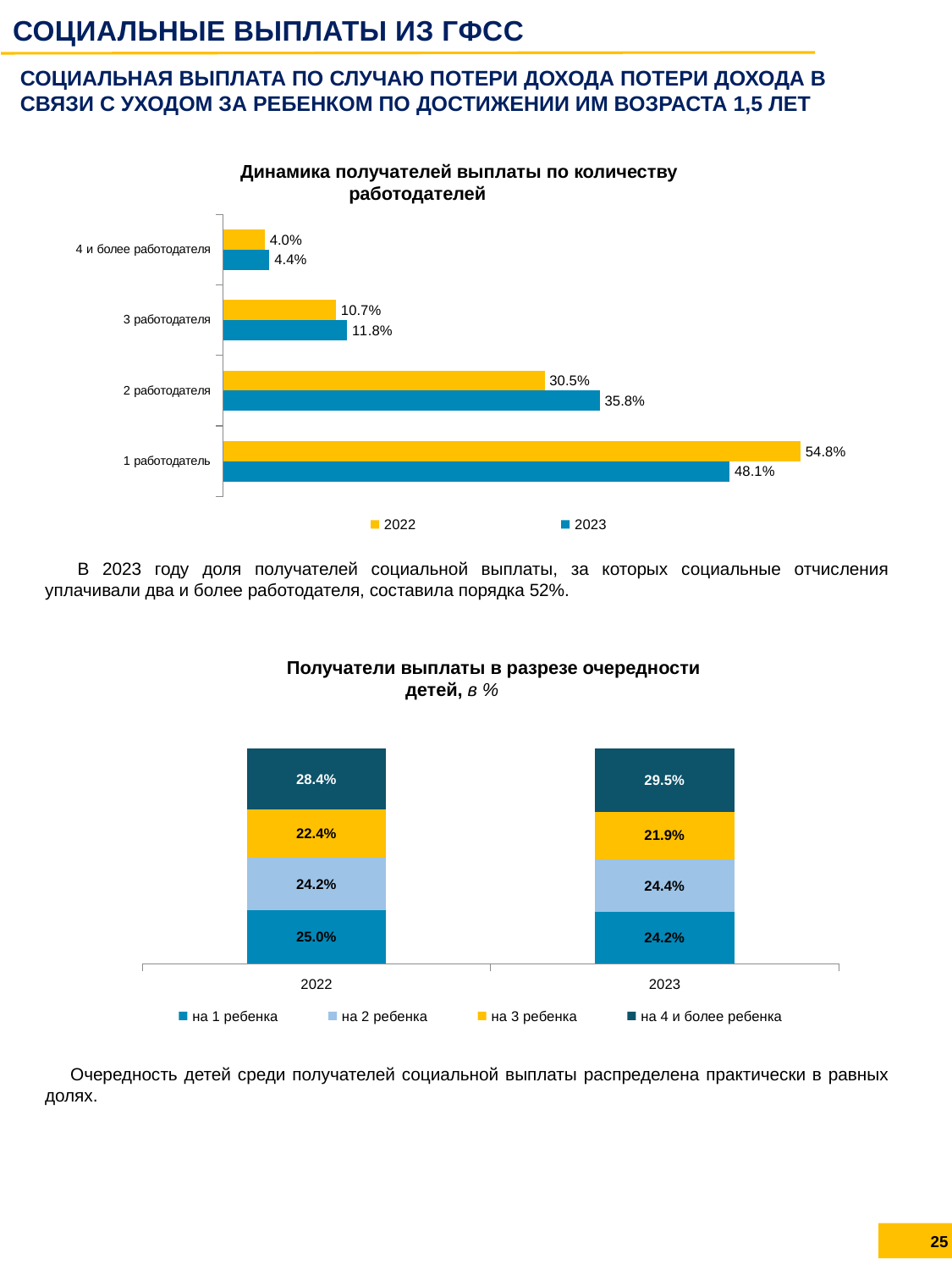
In the chart 'Получатели выплаты в разрезе очередности детей', what is the 2023 value for 'на 4 и более ребенка'? 29.5% In the chart 'Динамика получателей выплаты по количеству работодателей', how many series does the legend list? 2 In the chart 'Получатели выплаты в разрезе очередности детей', which series has the highest value in 2022? на 4 и более ребенка In the chart 'Получатели выплаты в разрезе очередности детей', what is the difference between the 2022 and 2023 values for 'на 3 ребенка'? 0.5% In the chart 'Динамика получателей выплаты по количеству работодателей', what is the 2022 value for '1 работодатель'? 54.8% In the chart 'Динамика получателей выплаты по количеству работодателей', which category has the lowest 2023 value? 4 и более работодателя In the chart 'Динамика получателей выплаты по количеству работодателей', which is larger for '3 работодателя': the 2022 value or the 2023 value? 2023 What kind of chart is 'Динамика получателей выплаты по количеству работодателей'? Bar chart In the chart 'Динамика получателей выплаты по количеству работодателей', what is the 2023 value for '2 работодателя'? 35.8% In the chart 'Получатели выплаты в разрезе очередности детей', what is the 2022 value for 'на 1 ребенка'? 25.0% In the chart 'Получатели выплаты в разрезе очередности детей', how many series does the legend list? 4 In the chart 'Динамика получателей выплаты по количеству работодателей', what is the difference between the 2022 and 2023 values for '1 работодатель'? 6.7%